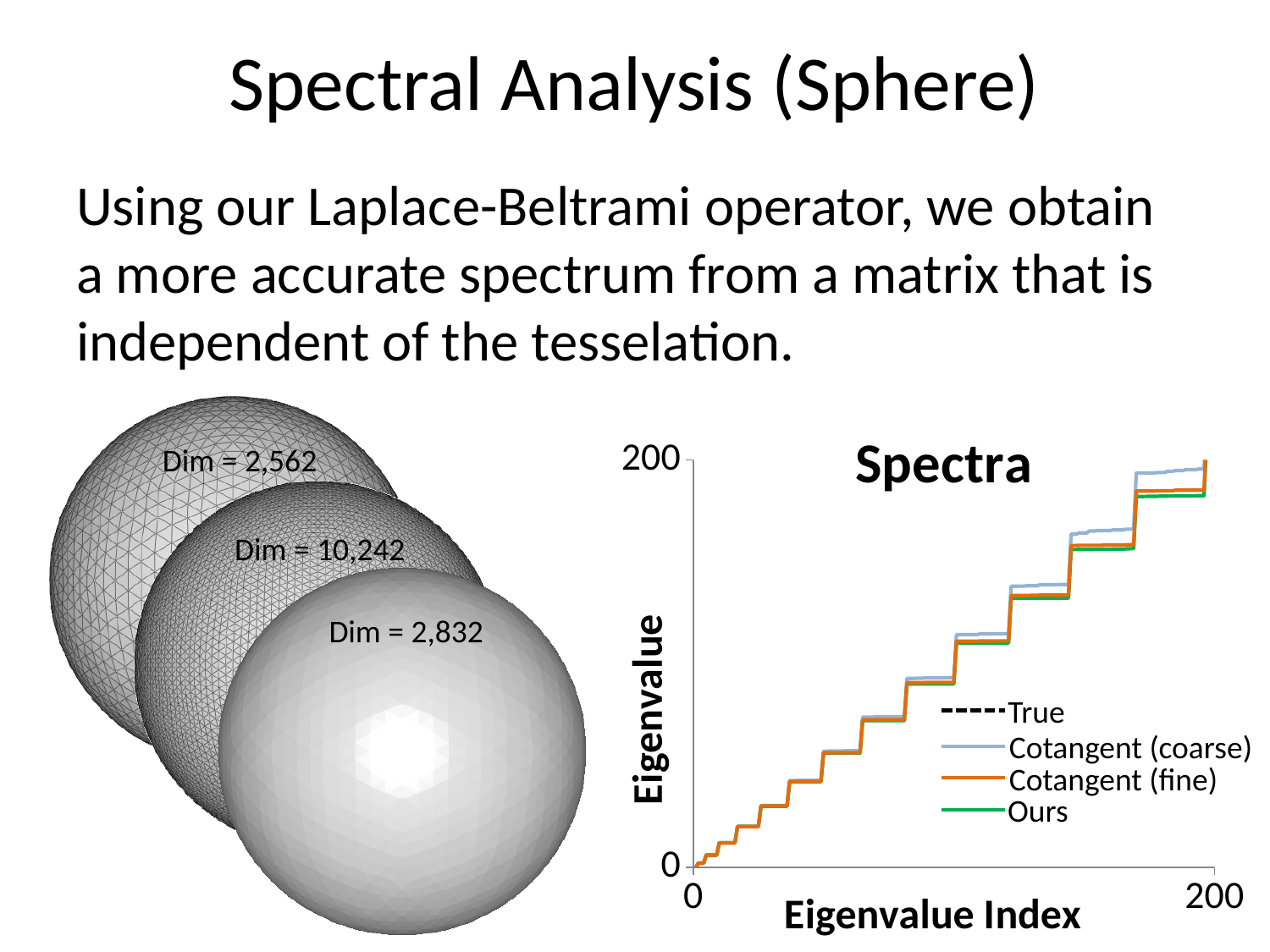
What is the title of the chart on the slide? Spectra What kind of chart is the "Spectra" chart? line chart How many series does the legend of the "Spectra" chart list? 4 What is the label of the x axis of the "Spectra" chart? Eigenvalue Index In the "Spectra" chart, which series is higher at the right end of the x axis, Cotangent (coarse) or Ours? Cotangent (coarse) Do the values in the "Spectra" chart rise or fall as the eigenvalue index increases? rise What is the maximum value shown on the y axis of the "Spectra" chart? 200